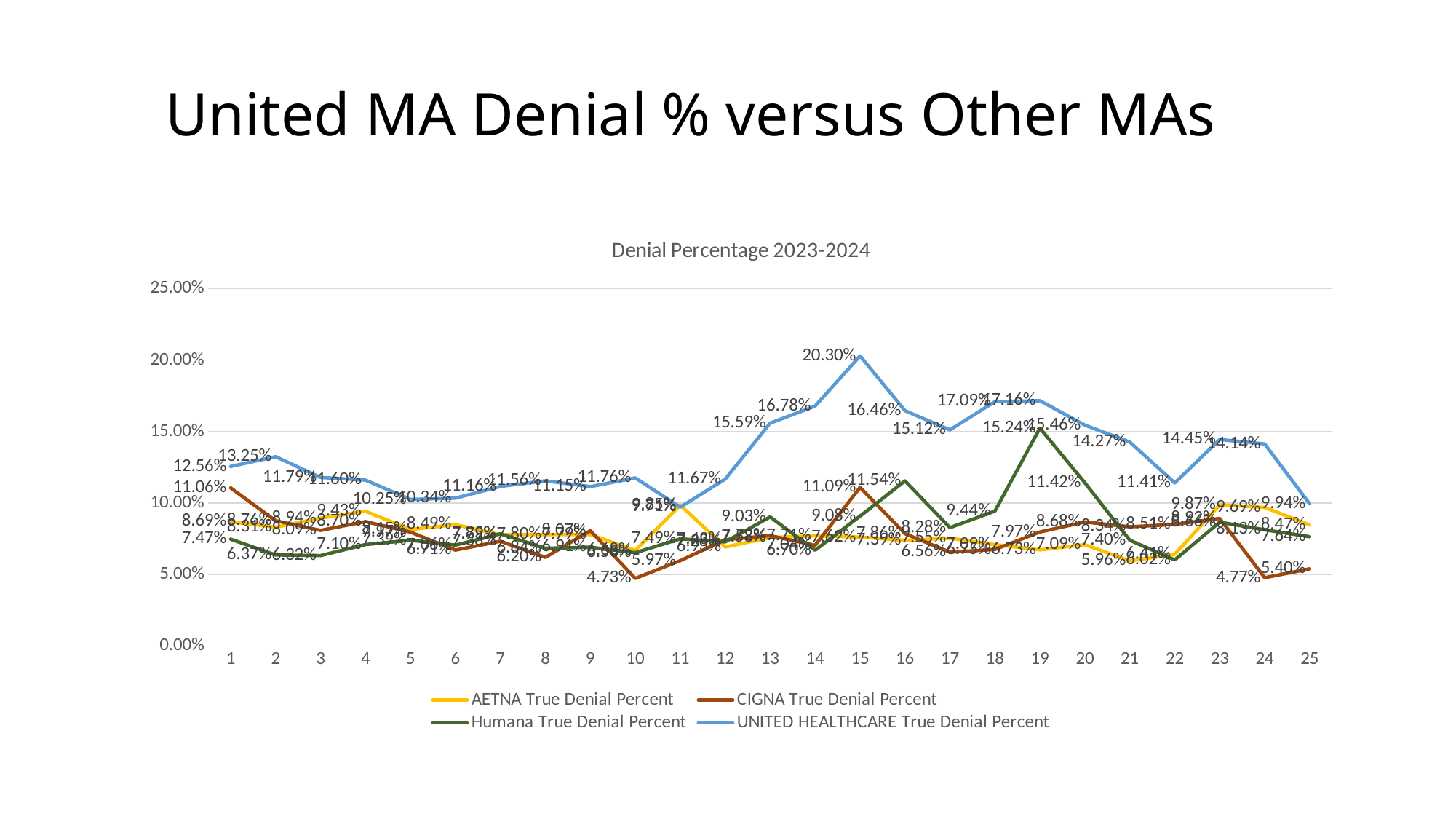
Which series is higher at point 15, UNITED HEALTHCARE True Denial Percent or CIGNA True Denial Percent? UNITED HEALTHCARE True Denial Percent What is the highest value of the UNITED HEALTHCARE True Denial Percent series? 20.30% What is the Humana True Denial Percent at point 19? 15.24% What is the title of the chart? Denial Percentage 2023-2024 What is the CIGNA True Denial Percent at point 10? 4.73% Is the UNITED HEALTHCARE True Denial Percent at point 15 greater or less than 20.00%? greater What kind of chart is shown on the slide? Line chart At which x-axis point does the UNITED HEALTHCARE True Denial Percent reach its highest value? 15 Is the Humana True Denial Percent at point 19 greater or less than 15.00%? greater How many series does the legend list? 4 How many points are plotted along the x axis? 25 What is the CIGNA True Denial Percent at point 1? 11.06%